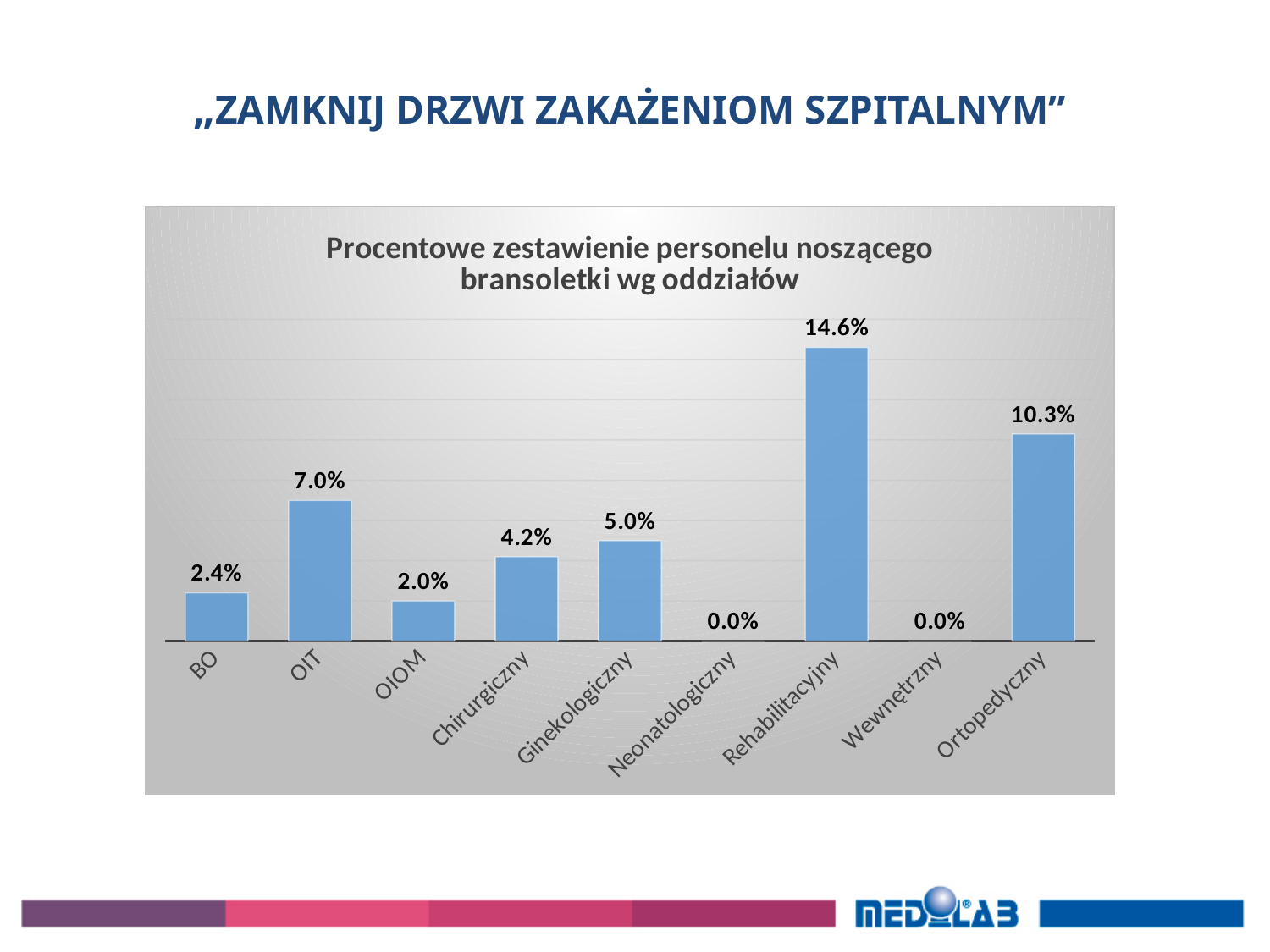
What is the difference between the values for Rehabilitacyjny and Ortopedyczny? 4.3% What is the title of the chart? Procentowe zestawienie personelu noszącego bransoletki wg oddziałów What is the value for Chirurgiczny? 4.2% Which categories have a value of 0.0%? Neonatologiczny and Wewnętrzny How many categories are shown on the x axis? 9 What is the value for Ortopedyczny? 10.3% What is the difference between the values for OIT and BO? 4.6% Which is larger, the value for Ginekologiczny or the value for Chirurgiczny? Ginekologiczny What kind of chart is this? Bar chart What is the value for Rehabilitacyjny? 14.6% Which category has the highest value? Rehabilitacyjny What is the value for OIT? 7.0%